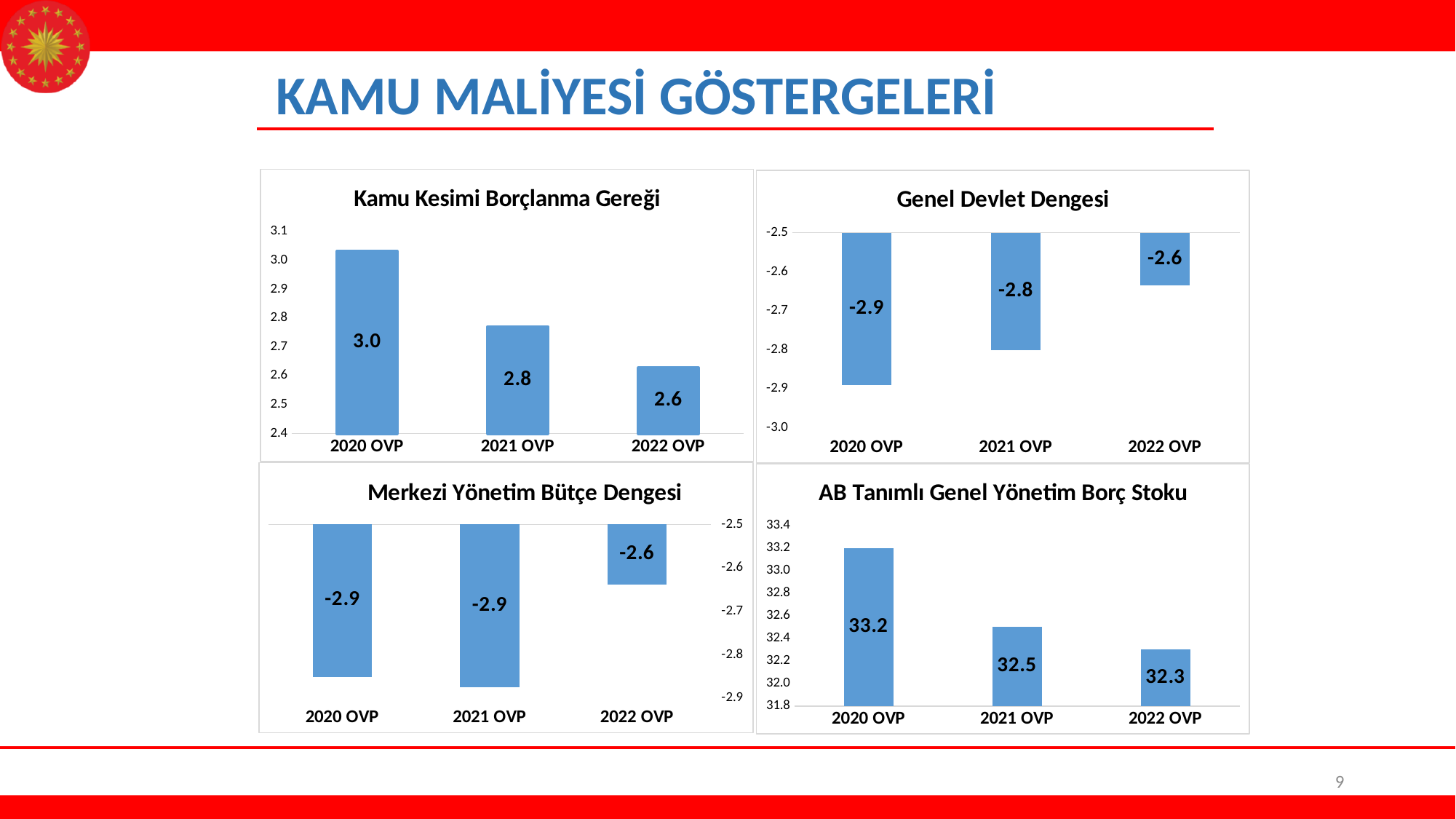
In the 'Kamu Kesimi Borçlanma Gereği' chart, what is the difference between the 2020 OVP and 2022 OVP values? 0.4 In the 'AB Tanımlı Genel Yönetim Borç Stoku' chart, what is the difference between the 2020 OVP and 2021 OVP values? 0.7 In the 'Genel Devlet Dengesi' chart, do the values rise or fall from 2020 OVP to 2022 OVP? rise In the 'Kamu Kesimi Borçlanma Gereği' chart, which category has the lowest value? 2022 OVP In the 'AB Tanımlı Genel Yönetim Borç Stoku' chart, which is larger, the value for 2020 OVP or 2022 OVP? 2020 OVP What type of chart is the 'Kamu Kesimi Borçlanma Gereği' chart? bar chart In the 'AB Tanımlı Genel Yönetim Borç Stoku' chart, what is the value for 2021 OVP? 32.5 In the 'Merkezi Yönetim Bütçe Dengesi' chart, what is the value for 2022 OVP? -2.6 In the 'Merkezi Yönetim Bütçe Dengesi' chart, how many categories are shown? 3 In the 'Kamu Kesimi Borçlanma Gereği' chart, what is the value for 2020 OVP? 3.0 In the 'Genel Devlet Dengesi' chart, what is the value for 2021 OVP? -2.8 In the 'Genel Devlet Dengesi' chart, which category has the highest value? 2022 OVP